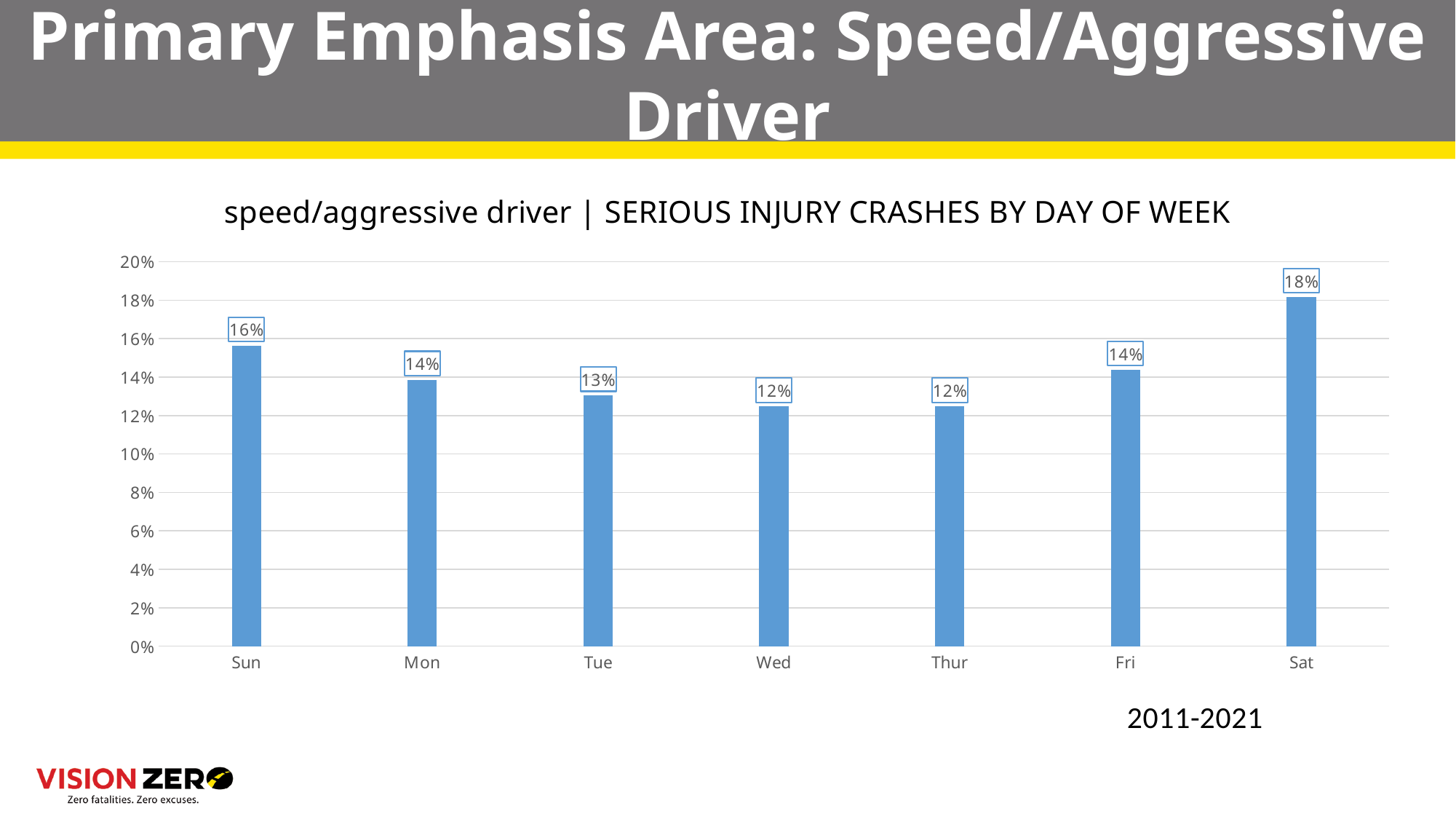
What time period is noted below the chart? 2011-2021 What is the value for Sat? 18% Which day has the highest share of serious injury crashes? Sat What is the title of the chart? speed/aggressive driver | SERIOUS INJURY CRASHES BY DAY OF WEEK Which is larger, the value for Mon or the value for Tue? Mon What kind of chart is shown on the slide? Bar chart What is the difference between the values for Sun and Wed? 4% What is the difference between the values for Sat and Sun? 2% What is the value for Sun? 16% What is the value for Wed? 12% How many days of the week are shown on the x axis? 7 Is the value for Sat greater or less than 16%? greater